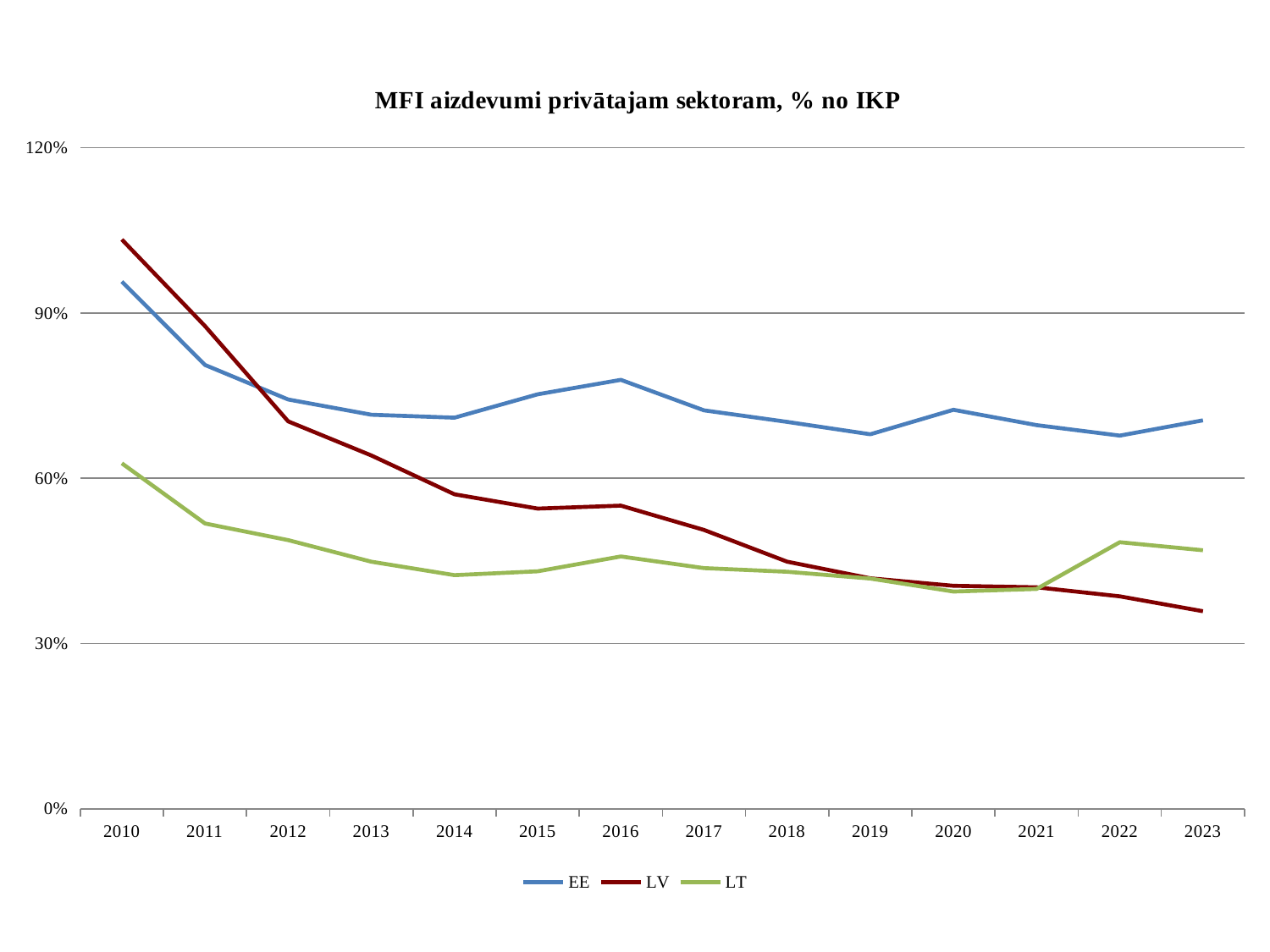
Does the LV series rise or fall from 2010 to 2023? fall How many series does the legend list? 3 What is the title of the chart? MFI aizdevumi privātajam sektoram, % no IKP Is the value for LT in 2014 greater or less than 60%? less In 2023, which series has the larger value, LT or LV? LT Is the value for EE in 2023 greater or less than 60%? greater Which series has the lowest value in 2010? LT Which series has the highest value in 2023? EE How many years are shown on the x axis? 14 Is the value for LV in 2010 greater or less than 90%? greater What kind of chart is shown on the slide? line chart In 2010, which series has the larger value, EE or LV? LV